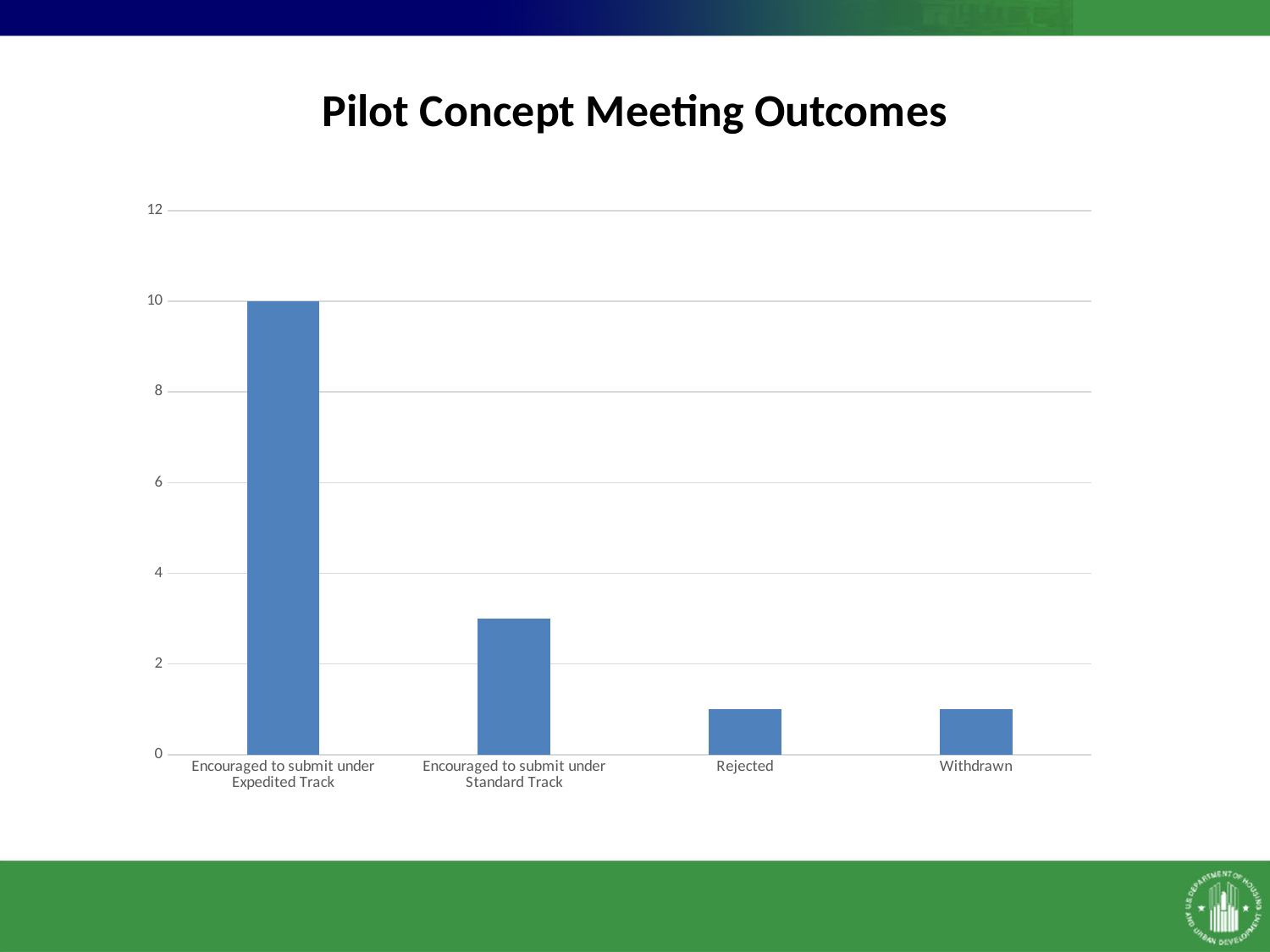
Is the value for Encouraged to submit under Expedited Track greater or less than 8? greater How many categories are shown on the x axis? 4 Is the value for Encouraged to submit under Standard Track greater or less than 2? greater What is the value for Encouraged to submit under Expedited Track? 10 Is the value for Withdrawn greater or less than 2? less What kind of chart is shown on the slide? bar chart Which category has the highest value? Encouraged to submit under Expedited Track Which is larger, the value for Encouraged to submit under Standard Track or the value for Rejected? Encouraged to submit under Standard Track Which is larger, the value for Encouraged to submit under Expedited Track or the value for Encouraged to submit under Standard Track? Encouraged to submit under Expedited Track What is the title of the chart? Pilot Concept Meeting Outcomes